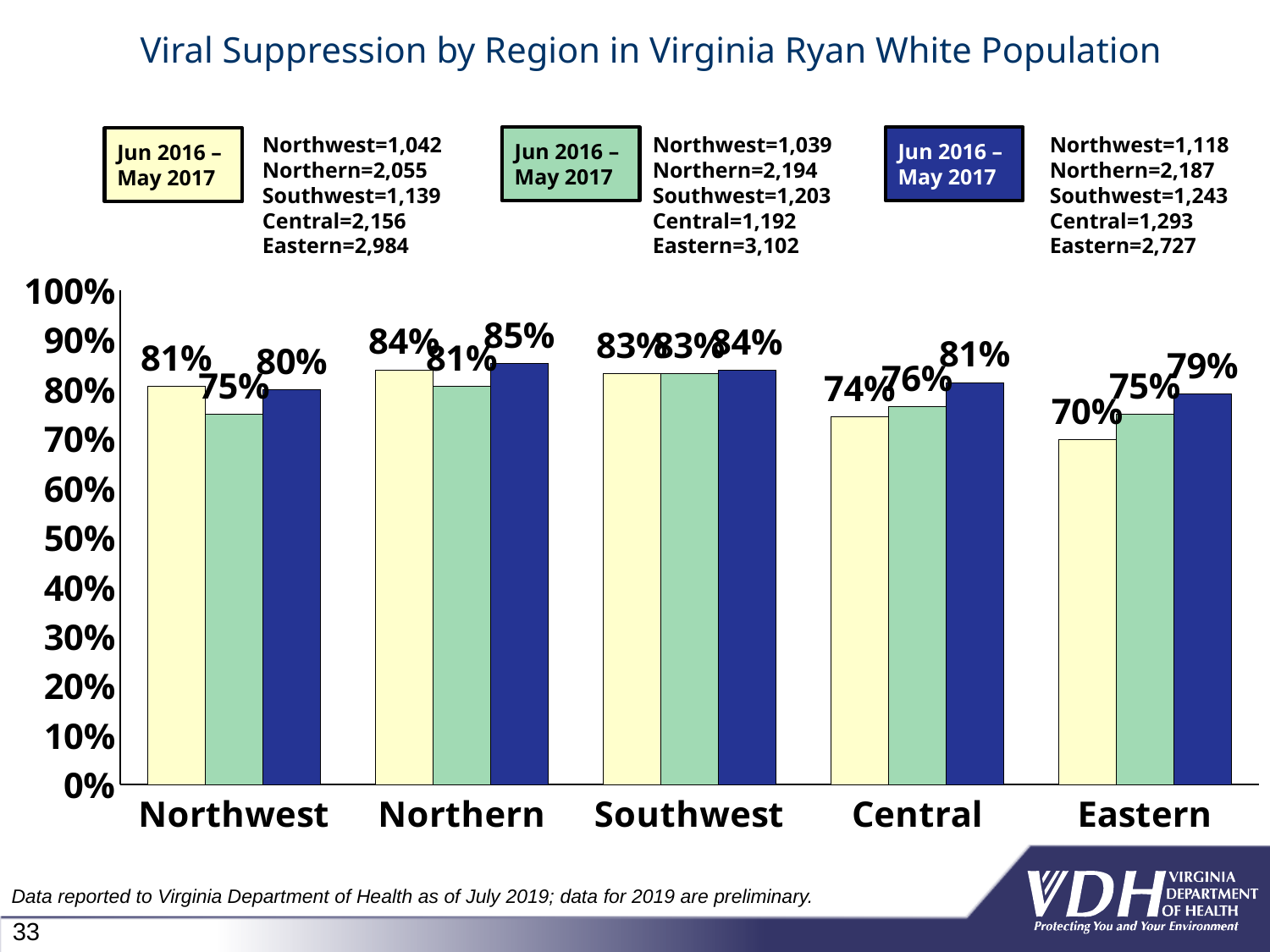
What is the value of the dark blue bar for the Northern region? 85% Which region has the lowest yellow bar value? Eastern How many series (coloured bar groups) does the chart show? 3 What is the difference between the dark blue bar and the yellow bar for the Eastern region? 9% What is the value of the green bar for the Central region? 76% How many regions are shown on the x axis? 5 Which region has the highest dark blue bar value? Northern What type of chart is shown on the slide? bar chart Which is larger for the Central region, the yellow bar or the dark blue bar? the dark blue bar What is the title of the chart? Viral Suppression by Region in Virginia Ryan White Population What is the value of the yellow bar for the Eastern region? 70% What is the viral suppression value for the yellow bar in the Northwest region? 81%